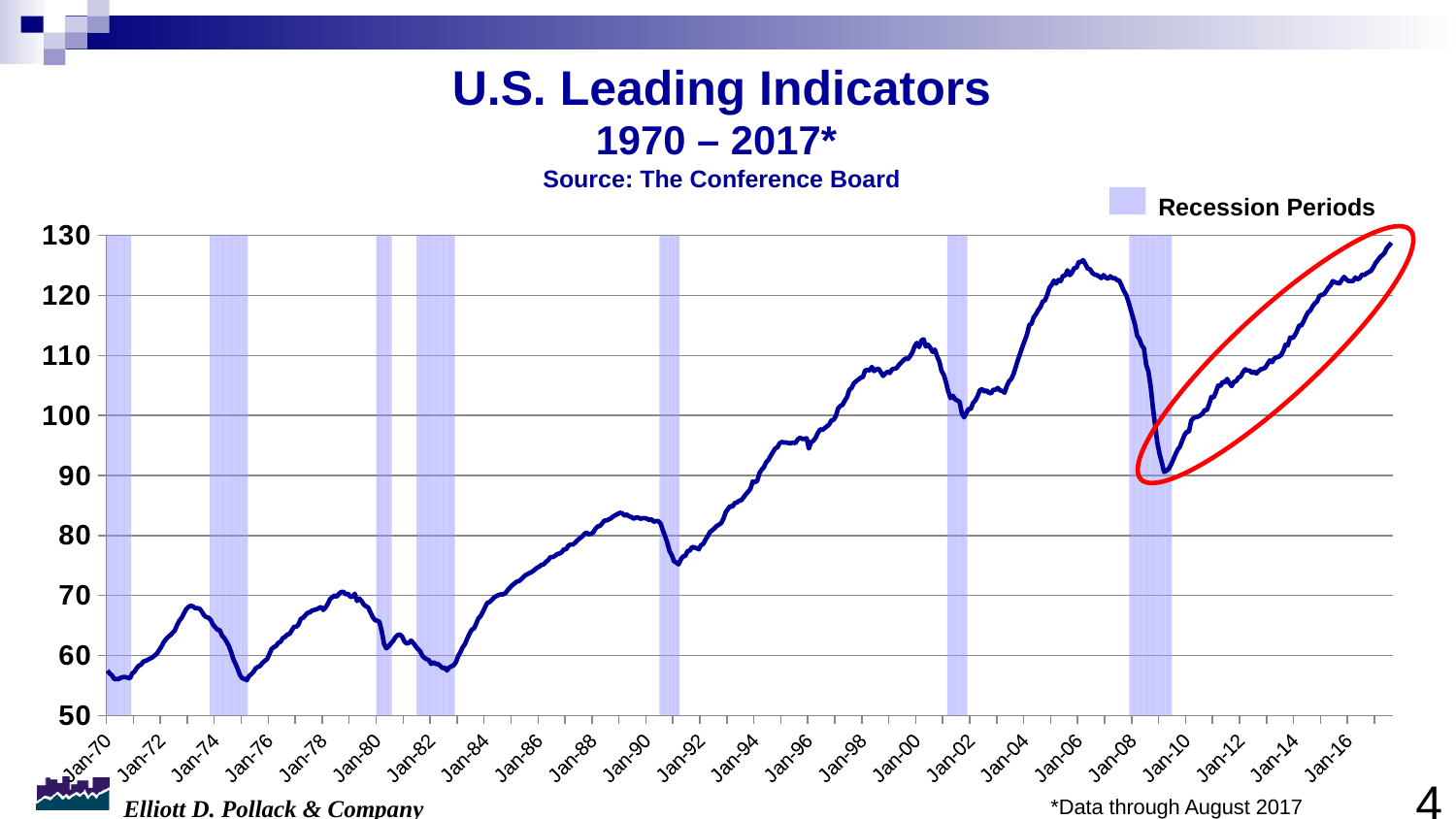
What kind of chart is shown on the slide? line chart Is the value at Jan-92 greater or less than 80? less Is the value at Jan-96 greater or less than 90? greater What do the shaded vertical bands on the chart represent, according to the legend? Recession Periods How many shaded recession periods are marked on the chart? 7 Is the value at Jan-70 greater or less than 60? less Which is larger, the value at Jan-06 or the value at Jan-10? Jan-06 Overall, do the values rise or fall from Jan-70 to the end of the series? rise Which is larger, the value at Jan-80 or the value at Jan-90? Jan-90 What is the title of the chart? U.S. Leading Indicators 1970 – 2017*